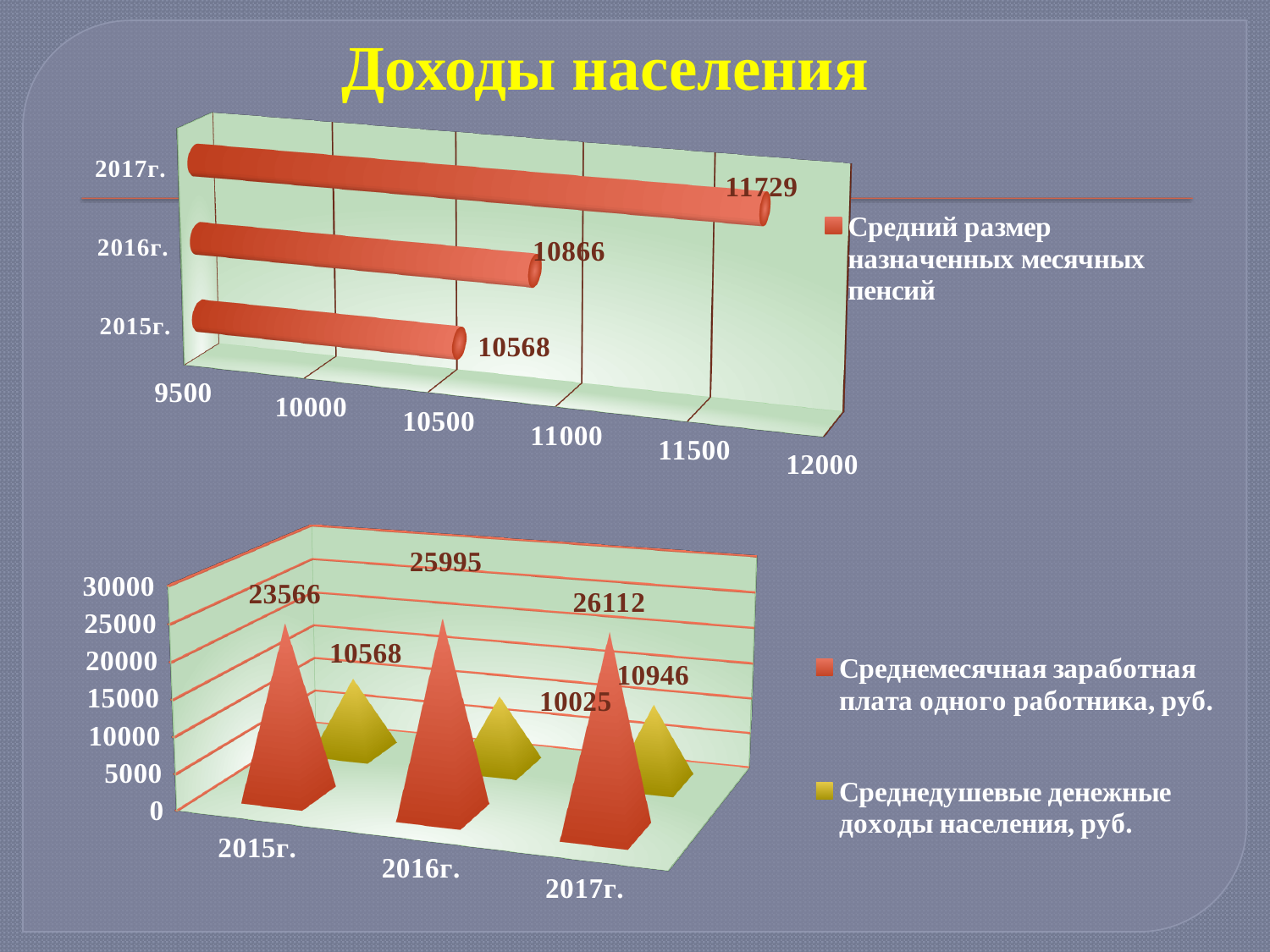
How many series does the legend of the bottom chart list? 2 In the bottom chart, which year has the highest Среднемесячная заработная плата одного работника? 2017г. In the top chart (Средний размер назначенных месячных пенсий), what is the value for 2017г.? 11729 How many years are shown on the x axis of the bottom chart? 3 In the top chart (Средний размер назначенных месячных пенсий), what is the value for 2015г.? 10568 In the top chart (Средний размер назначенных месячных пенсий), is the value for 2017г. greater or less than 11500? greater In the top chart (Средний размер назначенных месячных пенсий), which year has the highest value? 2017г. What kind of chart is the top chart on the slide? bar chart In the top chart (Средний размер назначенных месячных пенсий), what is the difference between the 2017г. and 2016г. values? 863 In the bottom chart, what is the value of Среднемесячная заработная плата одного работника for 2016г.? 25995 In the top chart, do the pension values rise or fall from 2015г. to 2017г.? rise In the bottom chart for 2015г., which is larger: Среднемесячная заработная плата одного работника or Среднедушевые денежные доходы населения? Среднемесячная заработная плата одного работника